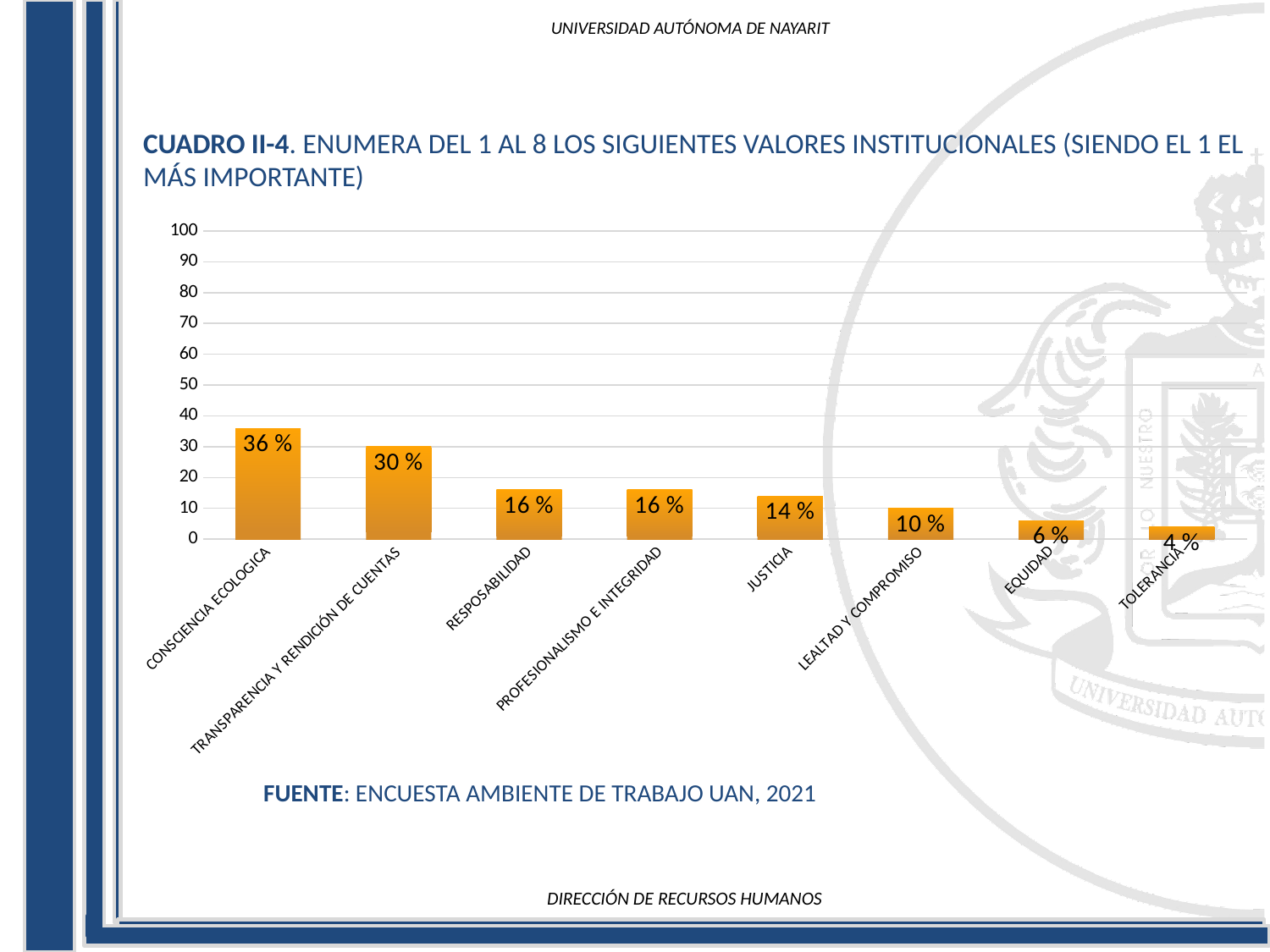
What is the difference between the values for CONSCIENCIA ECOLOGICA and TRANSPARENCIA Y RENDICIÓN DE CUENTAS? 6 % Which category has the highest value? CONSCIENCIA ECOLOGICA How many categories are shown in the chart? 8 Which is larger, the value for LEALTAD Y COMPROMISO or the value for EQUIDAD? LEALTAD Y COMPROMISO What kind of chart is shown on the slide? bar chart What is the value for TRANSPARENCIA Y RENDICIÓN DE CUENTAS? 30 % What is the value for JUSTICIA? 14 % Which category has the lowest value? TOLERANCIA What is the value for CONSCIENCIA ECOLOGICA? 36 % What is the value for TOLERANCIA? 4 % What source is cited below the chart? ENCUESTA AMBIENTE DE TRABAJO UAN, 2021 Is the value for RESPOSABILIDAD greater or less than 20? less